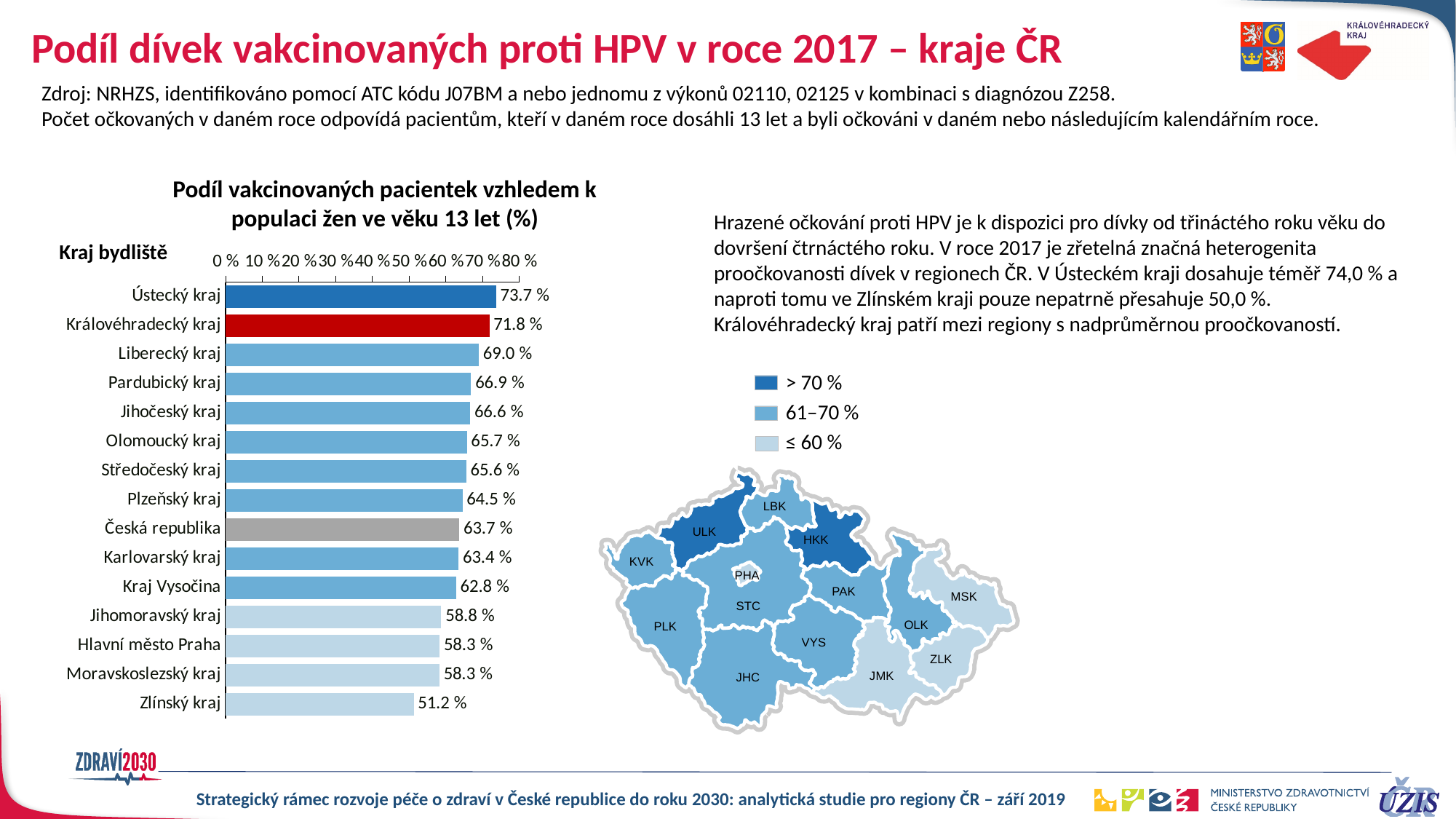
What is the value for Ústecký kraj in the bar chart? 73.7 % What is the difference between the value for Královéhradecký kraj and the value for Česká republika? 8.1 % Which region has the highest value in the bar chart? Ústecký kraj Which is larger, the value for Liberecký kraj or the value for Pardubický kraj? Liberecký kraj What is the difference between the values for Ústecký kraj and Zlínský kraj? 22.5 % What type of chart is used to show the share of vaccinated patients by region? bar chart What is the value for Královéhradecký kraj in the bar chart? 71.8 % How many bars are shown in the bar chart? 15 Which bar in the chart is coloured red? Královéhradecký kraj What is the value shown for Česká republika in the bar chart? 63.7 % Which region has the lowest value in the bar chart? Zlínský kraj What is the value for Jihomoravský kraj in the bar chart? 58.8 %